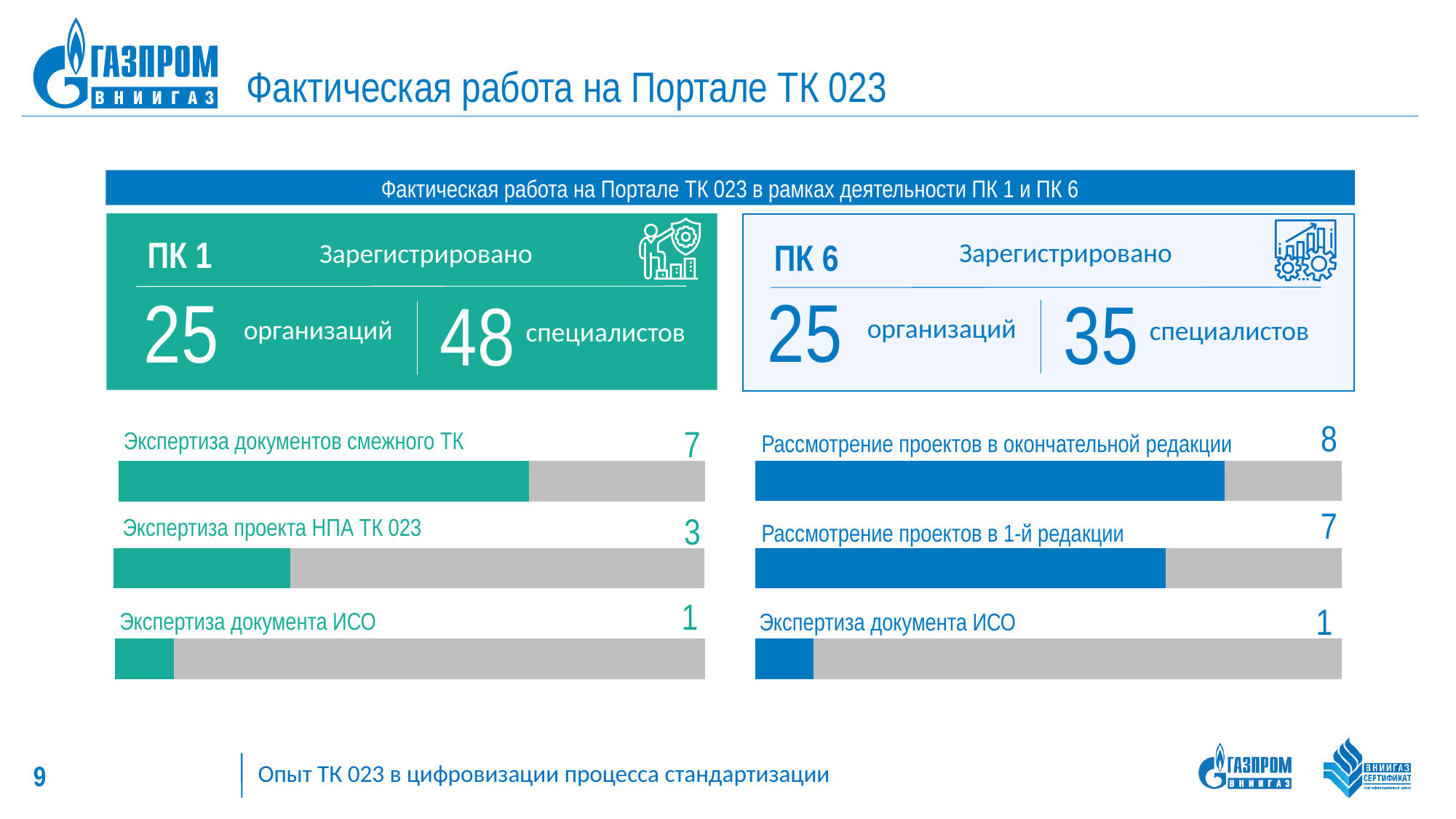
What kind of chart is used for the ПК 6 data on the right? Bar chart In the ПК 6 chart on the right, which category has the lowest value? Экспертиза документа ИСО In the ПК 1 chart on the left, what is the value for Экспертиза документов смежного ТК? 7 In the ПК 6 chart on the right, what is the difference between Рассмотрение проектов в окончательной редакции and Экспертиза документа ИСО? 7 In the ПК 1 chart on the left, what is the difference between Экспертиза документов смежного ТК and Экспертиза проекта НПА ТК 023? 4 In the ПК 1 chart on the left, which category has the highest value? Экспертиза документов смежного ТК In the ПК 6 chart on the right, what is the value for Рассмотрение проектов в окончательной редакции? 8 In the ПК 1 chart on the left, what is the value for Экспертиза проекта НПА ТК 023? 3 How many categories are shown in the ПК 1 chart on the left? 3 What colour are the bars in the ПК 1 chart on the left? Green In the ПК 6 chart on the right, what is the value for Рассмотрение проектов в 1-й редакции? 7 Which is larger: Рассмотрение проектов в окончательной редакции in the ПК 6 chart or Экспертиза документов смежного ТК in the ПК 1 chart? Рассмотрение проектов в окончательной редакции